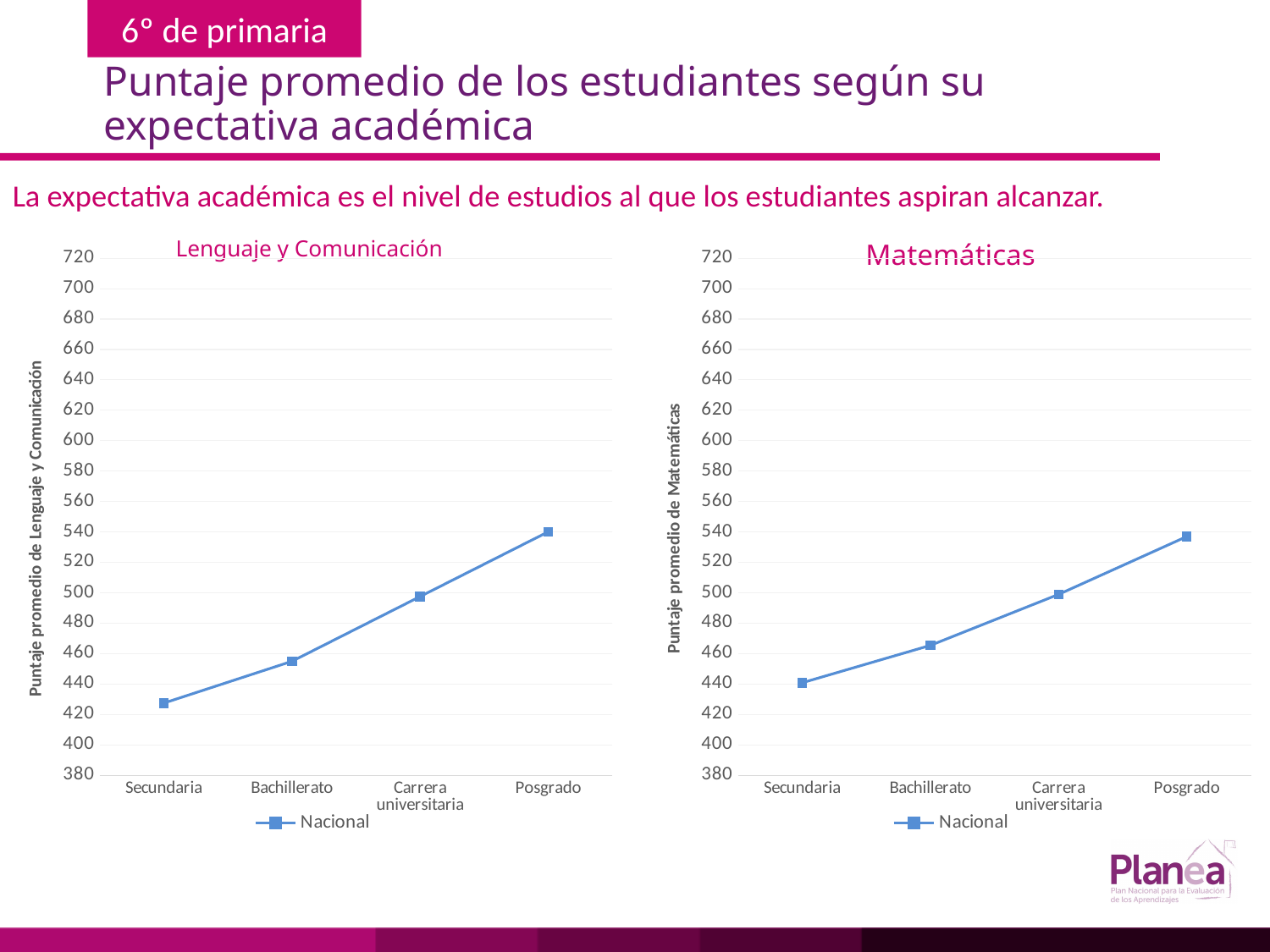
What kind of chart is the Lenguaje y Comunicación chart? line chart In the Matemáticas chart, is the value for Posgrado greater or less than 520? greater In the Lenguaje y Comunicación chart, is the value for Secundaria greater or less than 440? less In the Matemáticas chart, do the values rise or fall from Secundaria to Posgrado? rise How many series does the legend of the Lenguaje y Comunicación chart list? 1 In the Matemáticas chart, which expectativa académica category has the lowest average score? Secundaria In the Lenguaje y Comunicación chart, is the value for Carrera universitaria greater or less than 480? greater In the Lenguaje y Comunicación chart, which expectativa académica category has the highest average score? Posgrado How many expectativa académica categories are plotted on the x axis of the Matemáticas chart? 4